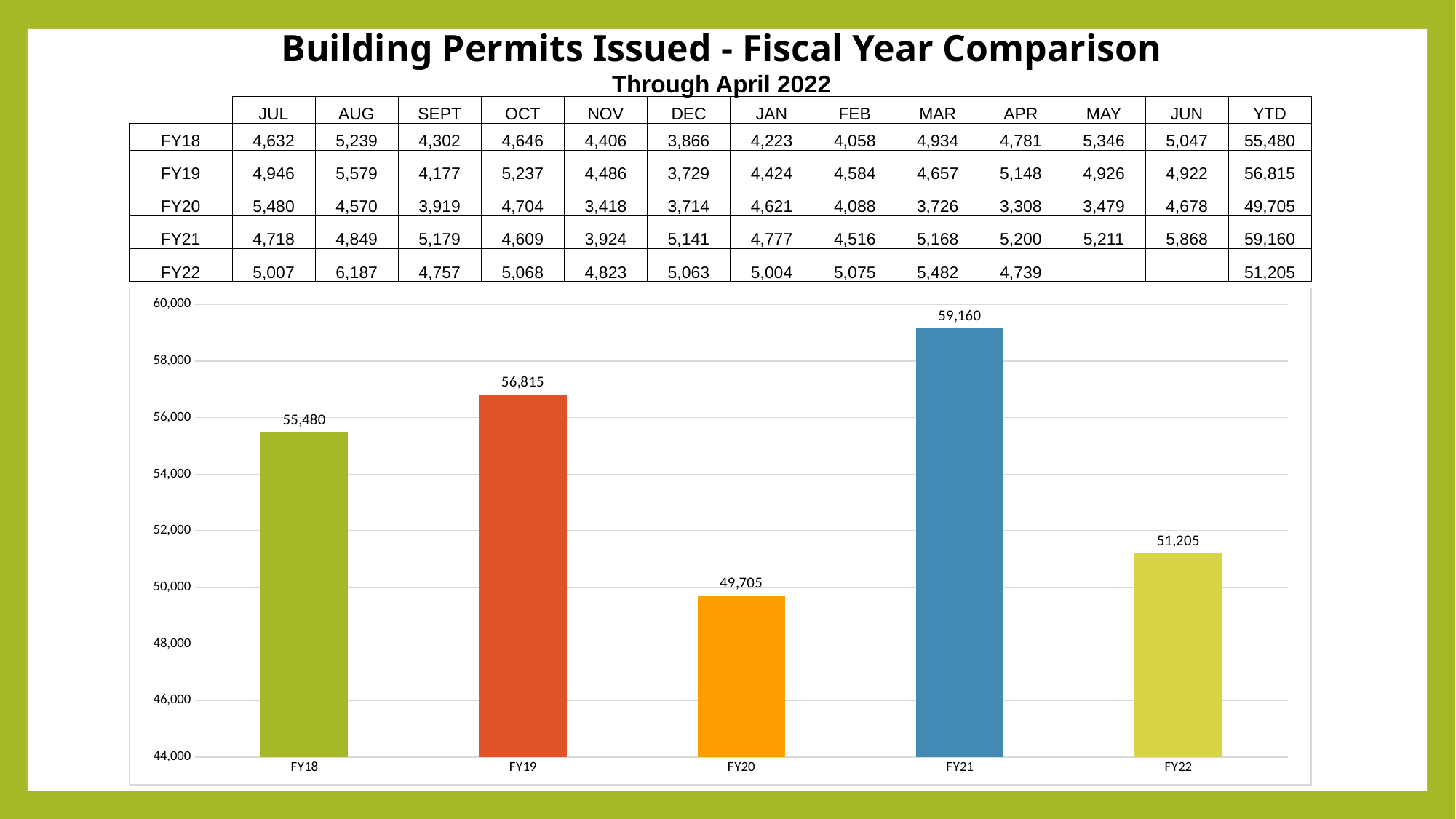
What is the value shown for FY22 in the bar chart? 51,205 What is the difference between the FY21 and FY20 values in the bar chart? 9,455 What is the value shown for FY20 in the bar chart? 49,705 How many bars are shown in the chart? 5 Which is larger in the bar chart, the value for FY18 or the value for FY22? FY18 Which fiscal year has the lowest bar in the chart? FY20 What is the difference between the FY19 and FY18 values in the bar chart? 1,335 Which fiscal year has the highest bar in the chart? FY21 What kind of chart is shown on the slide? bar chart Is the value for FY19 in the bar chart greater or less than 56,000? greater What is the title of the slide containing the chart? Building Permits Issued - Fiscal Year Comparison What is the value shown for FY21 in the bar chart? 59,160